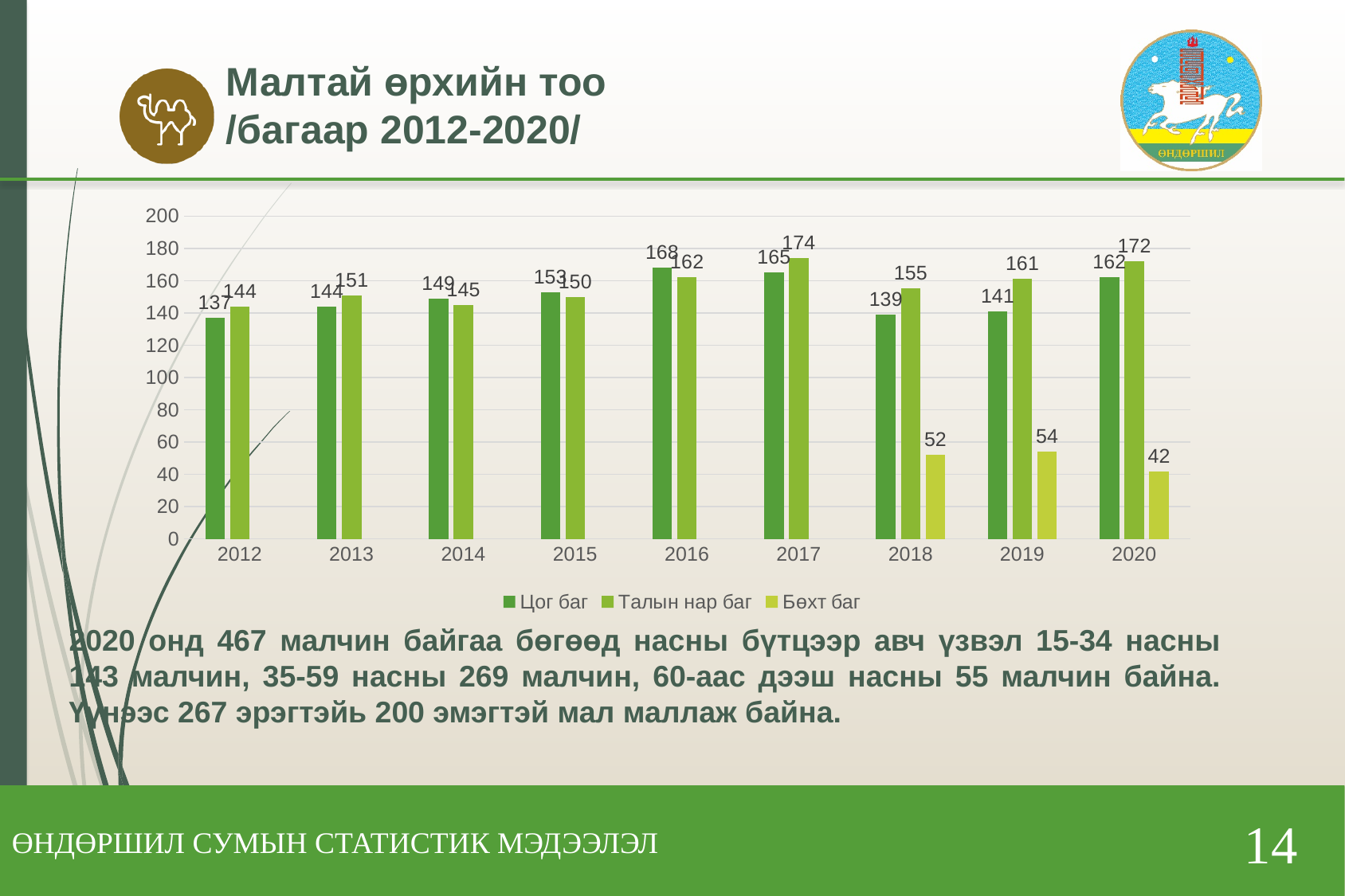
What is the value for Цог баг in 2016? 168 What kind of chart is shown on the slide? bar chart Is the value for Бөхт баг in 2019 greater or less than 60? less What is the difference between Талын нар баг and Цог баг in 2018? 16 What is the total of the three series in 2020? 376 Which is larger in 2014, Цог баг or Талын нар баг? Цог баг What is the value for Бөхт баг in 2020? 42 In which year is the value for Талын нар баг highest? 2017 In which year is the value for Цог баг lowest? 2012 How many series does the chart legend list? 3 What is the value for Талын нар баг in 2017? 174 How many years are shown on the x axis of the chart? 9